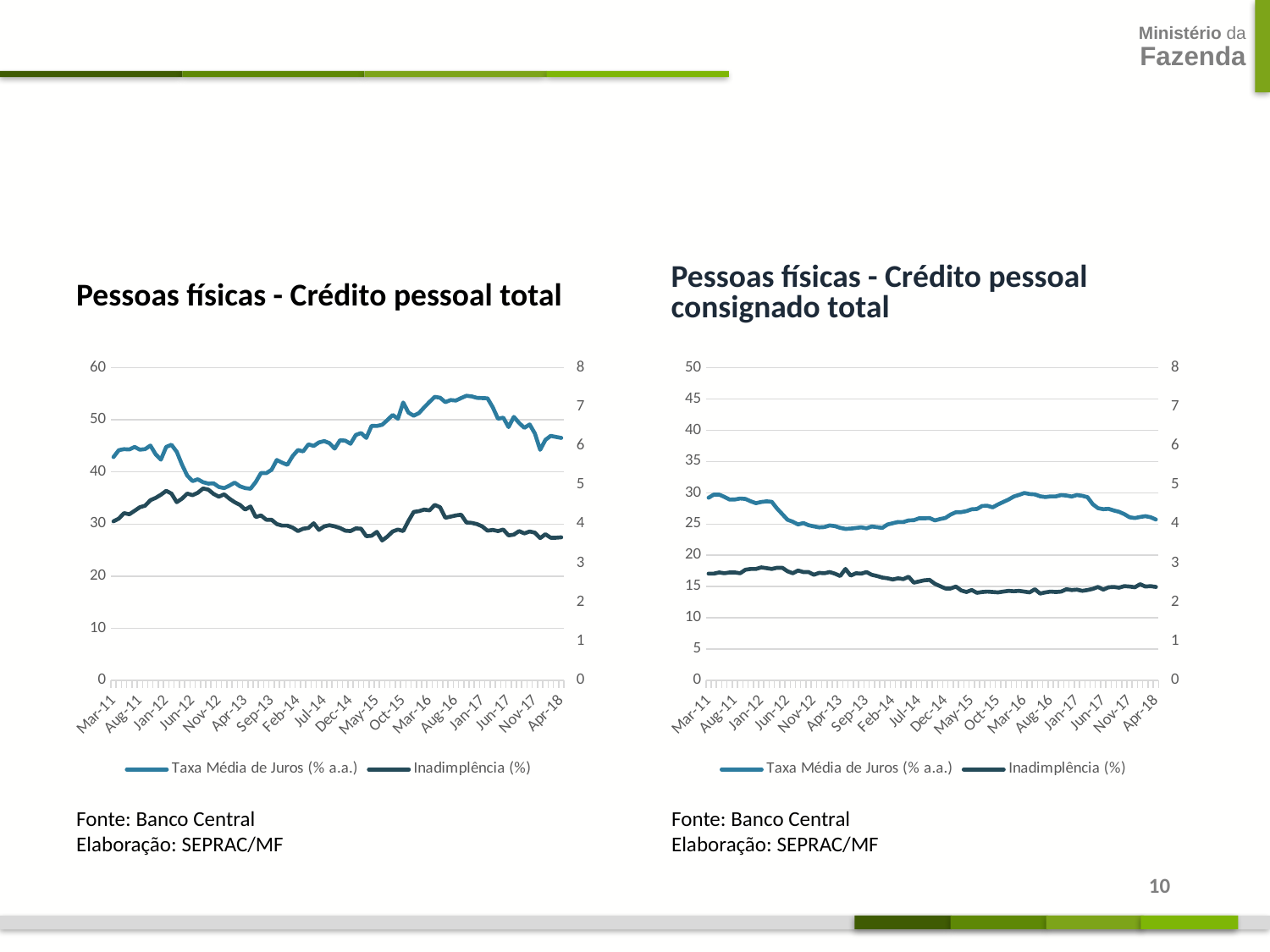
What kind of chart is the 'Pessoas físicas - Crédito pessoal total' chart on the left? Line chart In the 'Pessoas físicas - Crédito pessoal consignado total' chart, is the Taxa Média de Juros value at Apr-13 greater or less than 30? less In the 'Pessoas físicas - Crédito pessoal consignado total' chart, is the Taxa Média de Juros value at Mar-11 greater or less than 25? greater What are the two legend entries of the 'Pessoas físicas - Crédito pessoal total' chart? Taxa Média de Juros (% a.a.) and Inadimplência (%) In the 'Pessoas físicas - Crédito pessoal consignado total' chart, is the Inadimplência value at Mar-11 greater or less than 2 on the right axis? greater What is the title of the chart on the right side of the slide? Pessoas físicas - Crédito pessoal consignado total In the 'Pessoas físicas - Crédito pessoal total' chart, does the Taxa Média de Juros line generally rise or fall between Apr-13 and Aug-16? rise In the 'Pessoas físicas - Crédito pessoal consignado total' chart, does the Taxa Média de Juros line generally rise or fall between Mar-11 and Apr-13? fall How many series does the legend of the 'Pessoas físicas - Crédito pessoal consignado total' chart list? 2